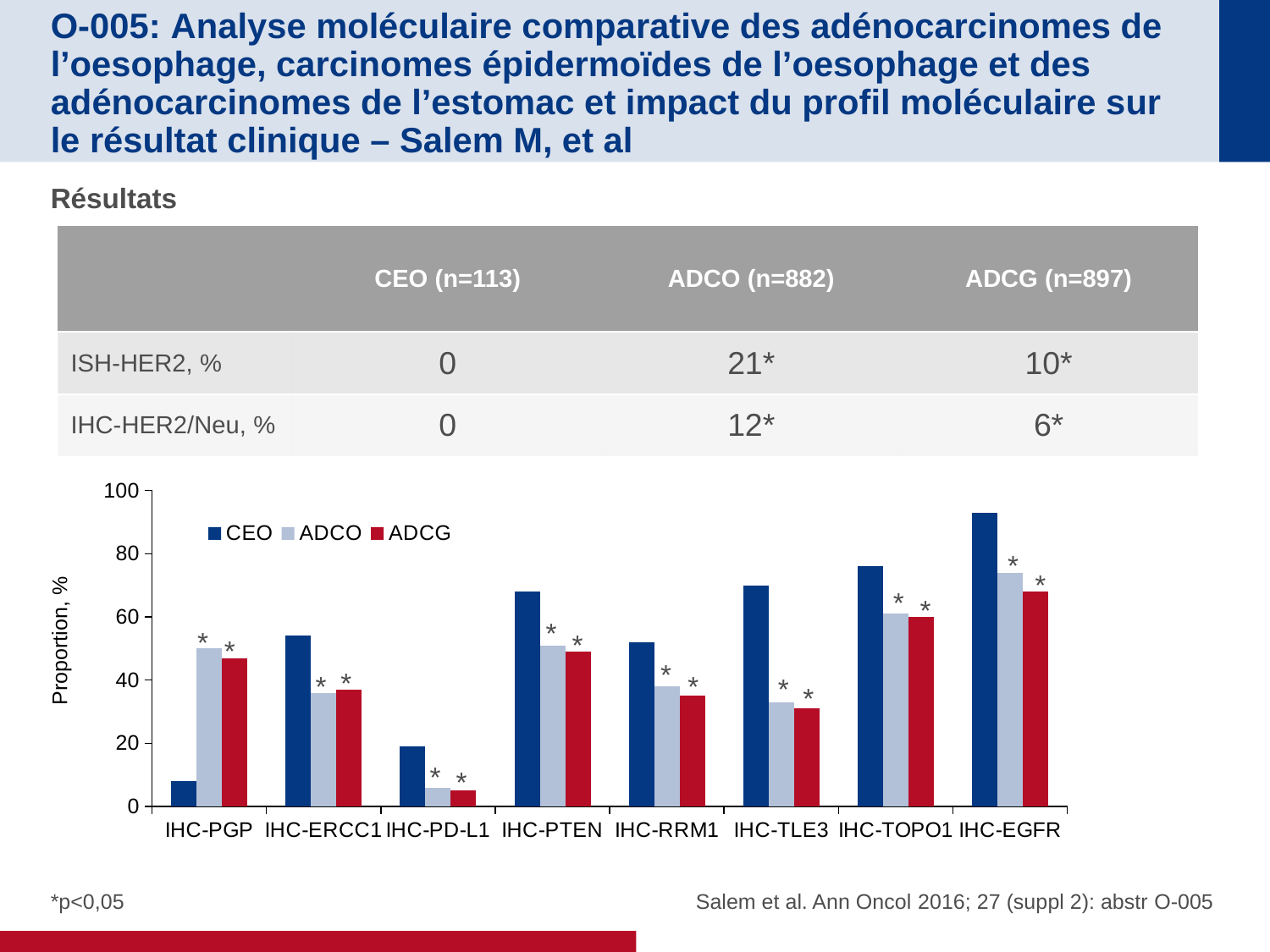
Which category has the lowest CEO bar in the chart? IHC-PGP How many series does the chart legend list? 3 How many IHC marker categories are shown on the x axis of the chart? 8 What is the label of the y axis of the chart? Proportion, % Which category has the lowest ADCG bar in the chart? IHC-PD-L1 For IHC-PGP, which is larger: the CEO bar or the ADCO bar? ADCO For IHC-TLE3, which is larger: the CEO bar or the ADCG bar? CEO Is the CEO value for IHC-TLE3 greater or less than 60? greater Which category has the highest CEO bar in the chart? IHC-EGFR Is the ADCO value for IHC-PD-L1 greater or less than 20? less Is the CEO value for IHC-EGFR greater or less than 80? greater What kind of chart is shown on the slide? Bar chart